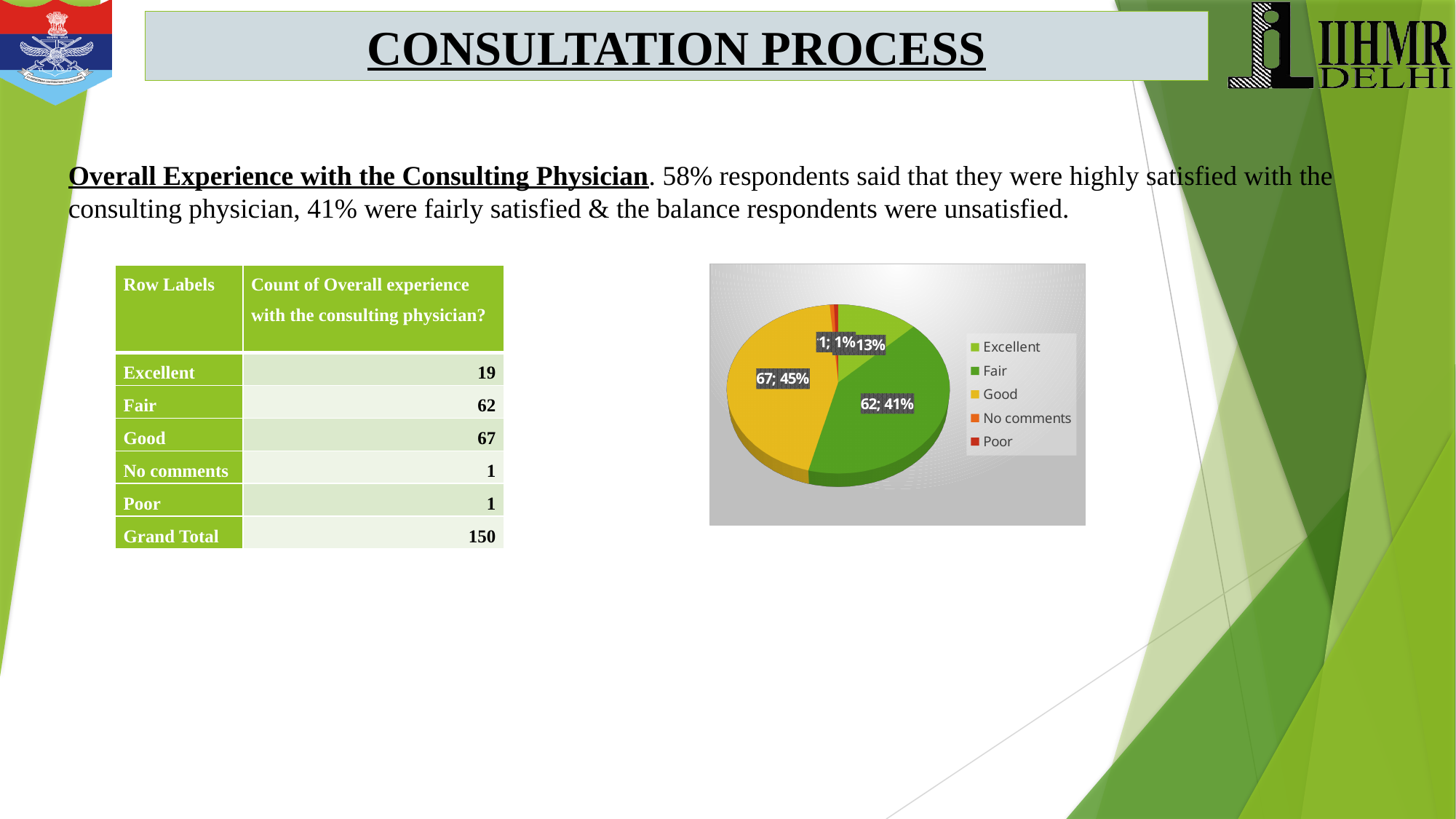
What percentage share does the pie chart show for the Good slice? 45% What kind of chart is shown on the slide? pie chart What is the count shown on the pie chart for the Fair slice? 62 What is the difference between the counts for Good and Fair shown on the pie chart? 5 What percentage share does the pie chart show for the Excellent slice? 13% Which slice is larger in the pie chart, Fair or Excellent? Fair What colour is the Good slice in the pie chart? yellow What is the count shown on the pie chart for the Good slice? 67 What percentage share does the pie chart show for the Fair slice? 41% Which slice is larger in the pie chart, Good or Fair? Good Which category has the largest slice in the pie chart? Good How many categories does the pie chart's legend list? 5